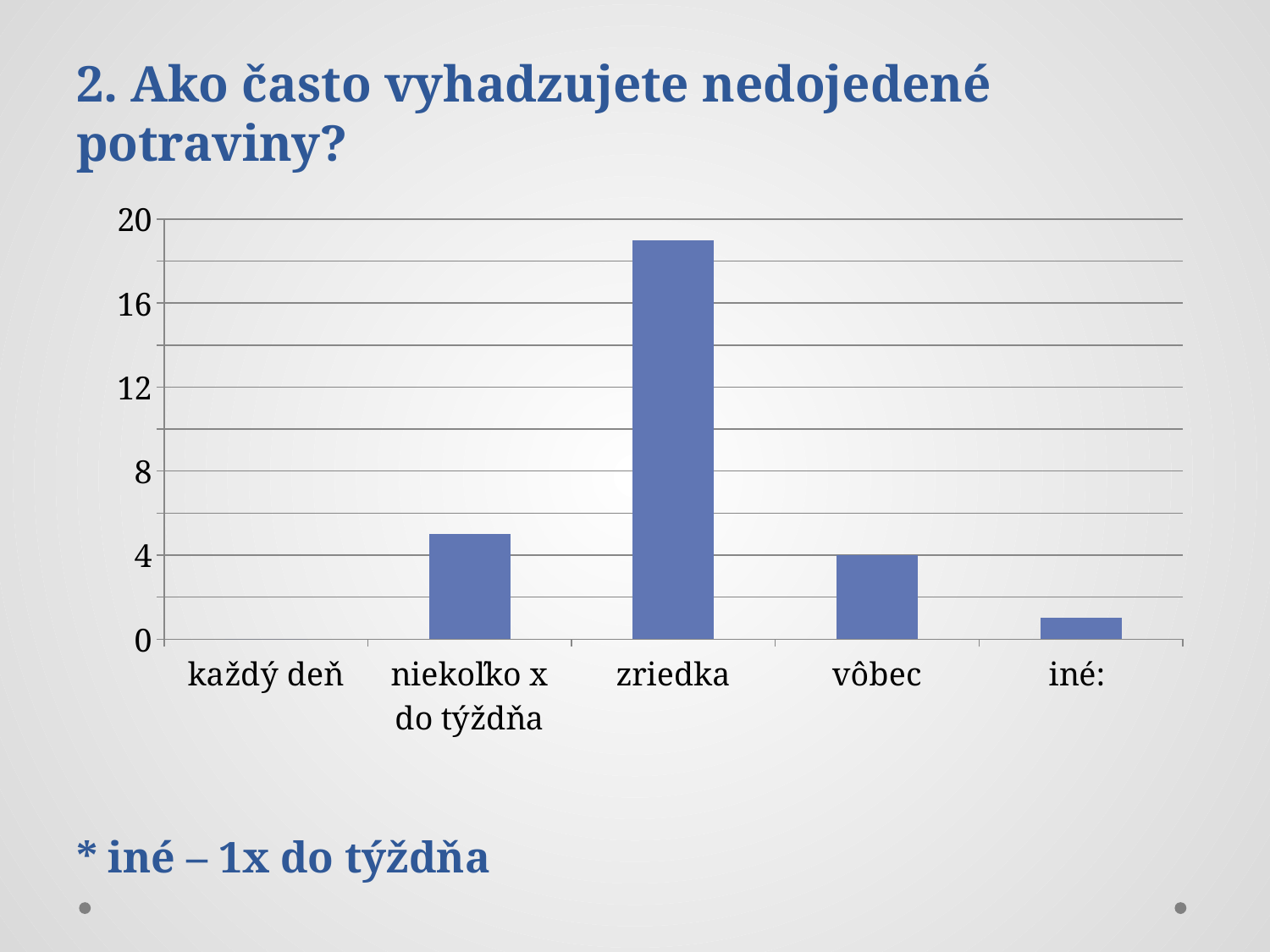
Is the value for iné: greater or less than 4? less Which category has the highest bar in the chart? zriedka What kind of chart is shown on the slide? bar chart Which is larger, the value for zriedka or the value for vôbec? zriedka What is the value for vôbec in the chart? 4 Is the value for zriedka greater or less than 16? greater Is the value for niekoľko x do týždňa greater or less than 8? less How many categories are shown on the x axis of the chart? 5 Which is larger, the value for niekoľko x do týždňa or the value for iné:? niekoľko x do týždňa What is the value for každý deň in the chart? 0 What is the highest value shown on the vertical axis of the chart? 20 Which category has the lowest value in the chart? každý deň